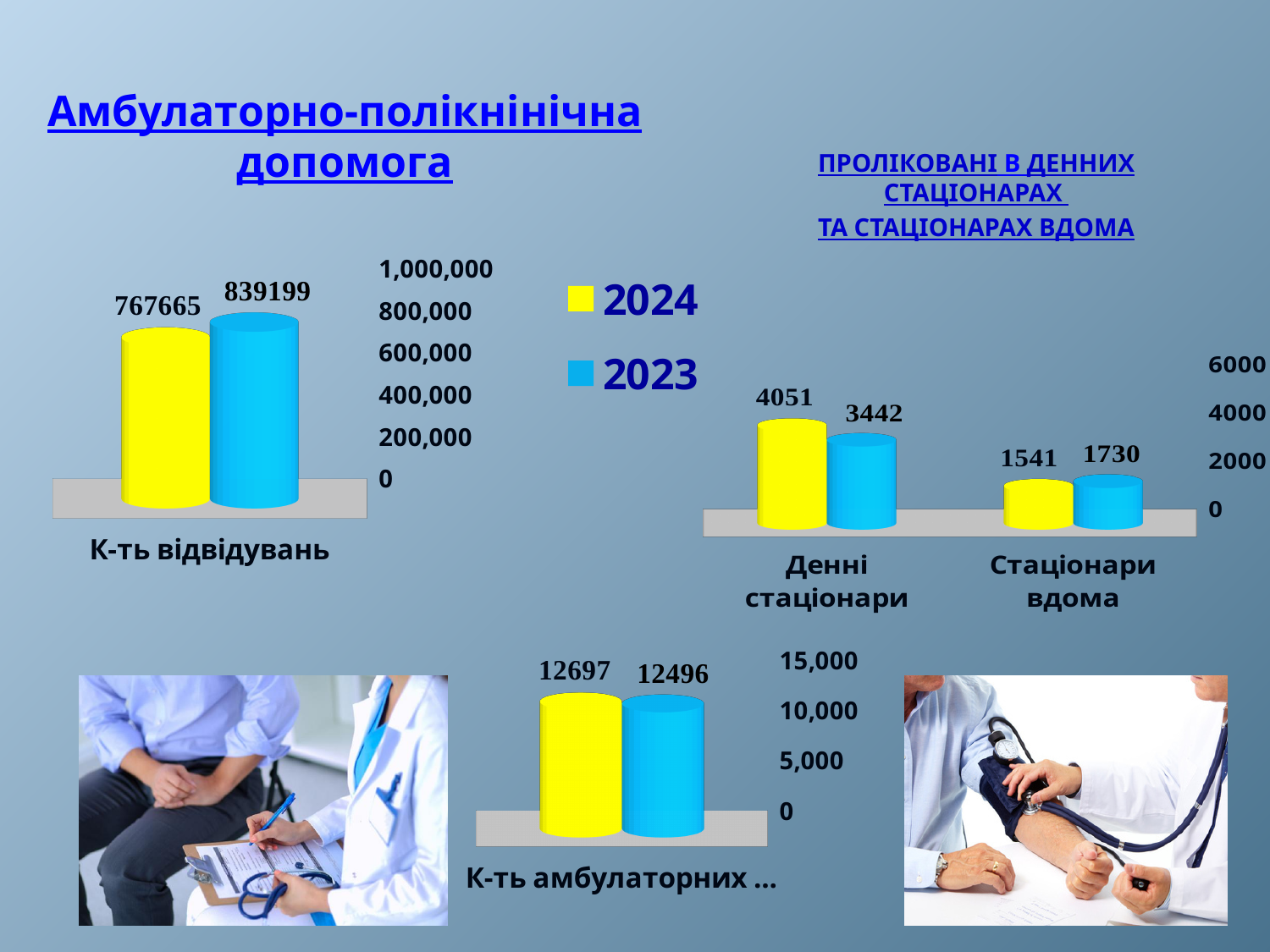
In the chart 'Проліковані в денних стаціонарах та стаціонарах вдома' (top right), what is the difference between the 2024 and 2023 values for 'Денні стаціонари'? 609 In the chart 'К-ть відвідувань' (top left), what is the value for 2024? 767665 In the chart 'Проліковані в денних стаціонарах та стаціонарах вдома' (top right), how many categories are shown on the x axis? 2 In the chart 'К-ть відвідувань' (top left), what is the difference between the 2023 and 2024 values? 71534 In the chart 'К-ть амбулаторних ...' (bottom centre), what is the value for 2024? 12697 In the chart 'К-ть амбулаторних ...' (bottom centre), what is the difference between the 2024 and 2023 values? 201 In the chart 'Проліковані в денних стаціонарах та стаціонарах вдома' (top right), which is larger for 'Стаціонари вдома': 2024 or 2023? 2023 What kind of chart is 'К-ть відвідувань' (top left)? bar chart In the chart 'Проліковані в денних стаціонарах та стаціонарах вдома' (top right), what is the 2023 value for 'Стаціонари вдома'? 1730 In the chart 'Проліковані в денних стаціонарах та стаціонарах вдома' (top right), what is the 2024 value for 'Денні стаціонари'? 4051 In the chart 'К-ть відвідувань' (top left), what is the value for 2023? 839199 How many series does the legend list for the charts on the slide? 2